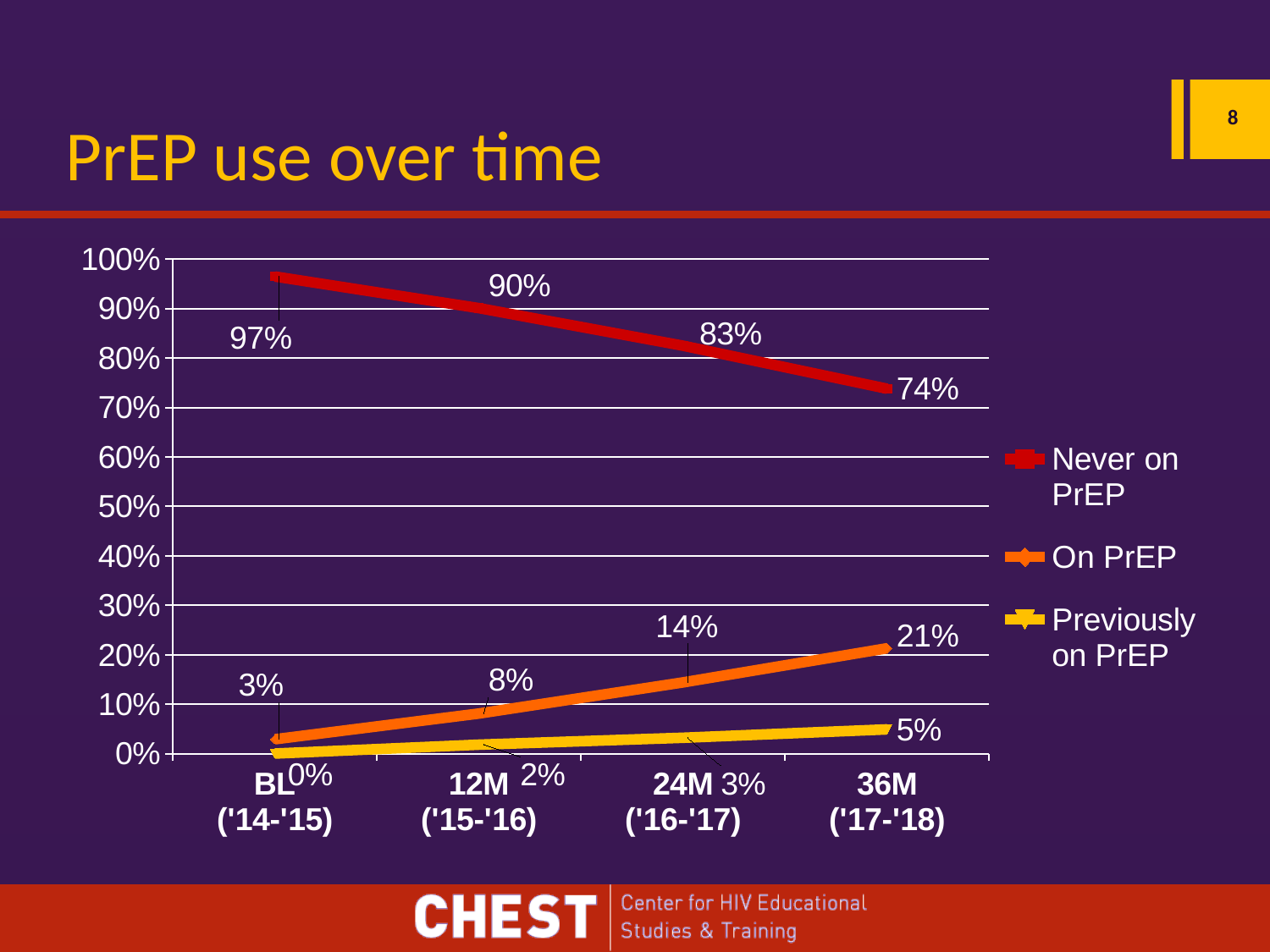
Which is larger at 24M ('16-'17): On PrEP or Previously on PrEP? On PrEP What is the value for Previously on PrEP at 24M ('16-'17)? 3% What is the value for Never on PrEP at 12M ('15-'16)? 90% What is the value for Never on PrEP at BL ('14-'15)? 97% At which time point is the Never on PrEP series lowest? 36M ('17-'18) What is the difference between the Never on PrEP values at BL ('14-'15) and 36M ('17-'18)? 23% Does the Never on PrEP series rise or fall from BL to 36M? fall How many time points are shown on the x axis? 4 How many series does the legend list? 3 What kind of chart is shown on the slide? line chart What is the value for On PrEP at 36M ('17-'18)? 21% At which time point is the On PrEP series highest? 36M ('17-'18)